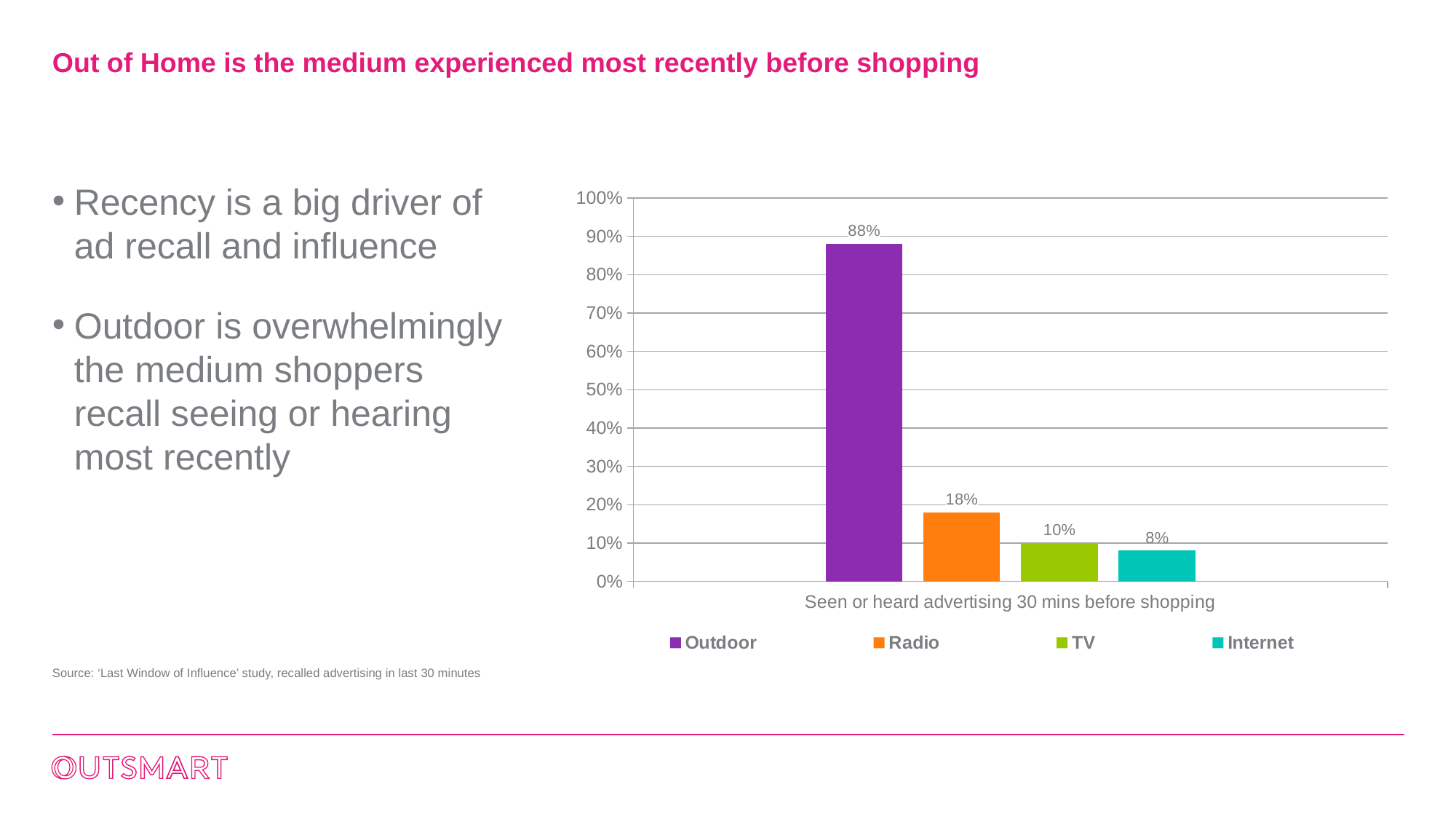
How many series does the legend list? 4 What kind of chart is shown on the slide? Bar chart Which is larger, the value for Radio or the value for TV? Radio What percentage of shoppers recalled seeing or hearing Outdoor advertising 30 mins before shopping? 88% What is the difference between the Outdoor and Radio values? 70% What is the value shown for Radio in the chart? 18% What is the value shown for Internet in the chart? 8% What is the value shown for TV in the chart? 10% What is the difference between the TV and Internet values? 2% Which medium has the highest value in the chart? Outdoor Which medium has the lowest value in the chart? Internet What is the label on the x axis of the chart? Seen or heard advertising 30 mins before shopping